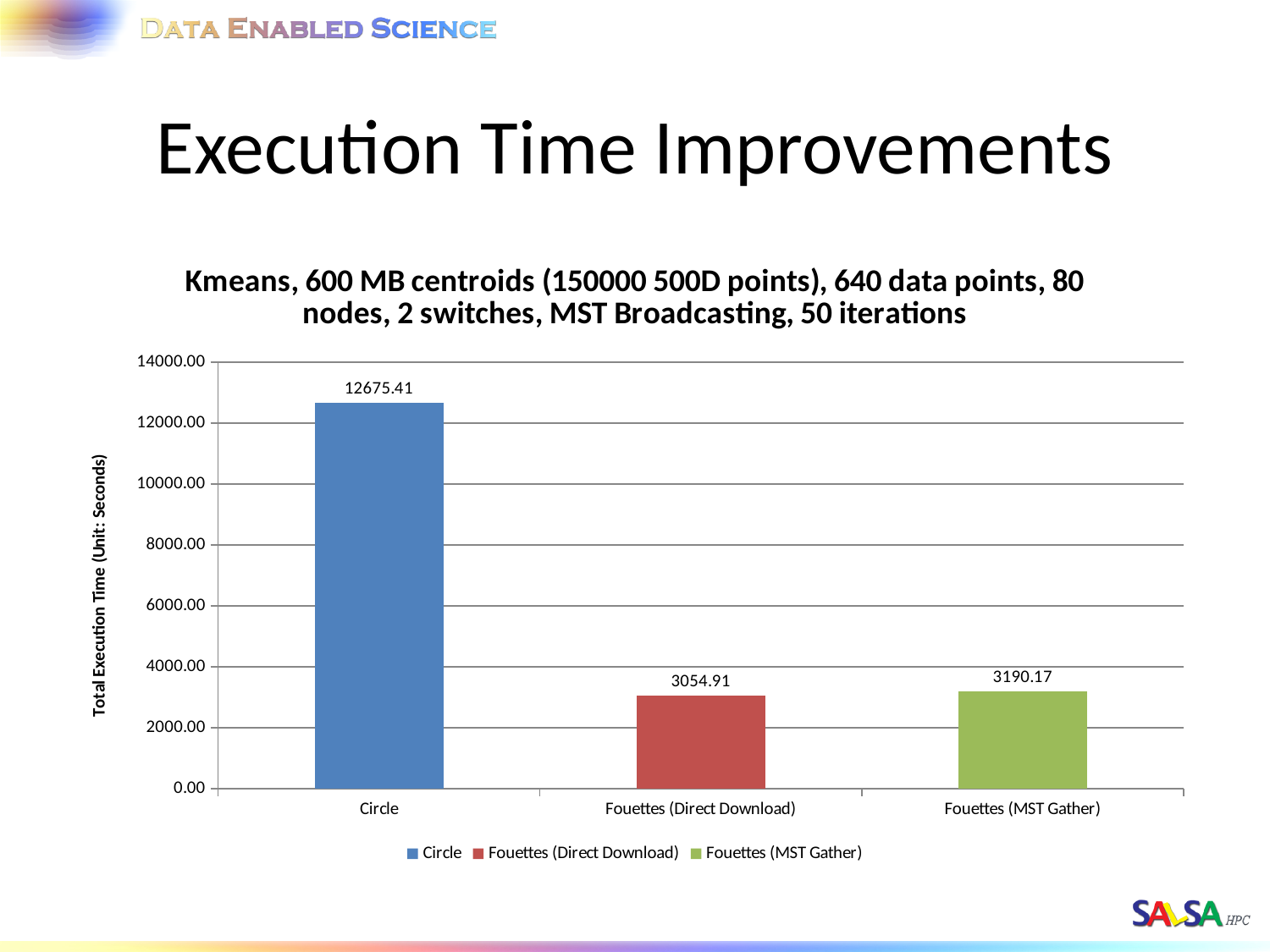
What is the label of the y axis? Total Execution Time (Unit: Seconds) How many categories are shown on the x axis? 3 What is the difference in execution time between Fouettes (MST Gather) and Fouettes (Direct Download)? 135.26 What is the total execution time for Circle? 12675.41 Which category has the highest total execution time? Circle What is the total execution time for Fouettes (MST Gather)? 3190.17 Which has a larger execution time, Fouettes (Direct Download) or Fouettes (MST Gather)? Fouettes (MST Gather) What kind of chart is shown on the slide? bar chart Is the value for Circle greater or less than 12000.00? greater What is the difference in execution time between Circle and Fouettes (Direct Download)? 9620.50 What is the total execution time for Fouettes (Direct Download)? 3054.91 Which category has the lowest total execution time? Fouettes (Direct Download)